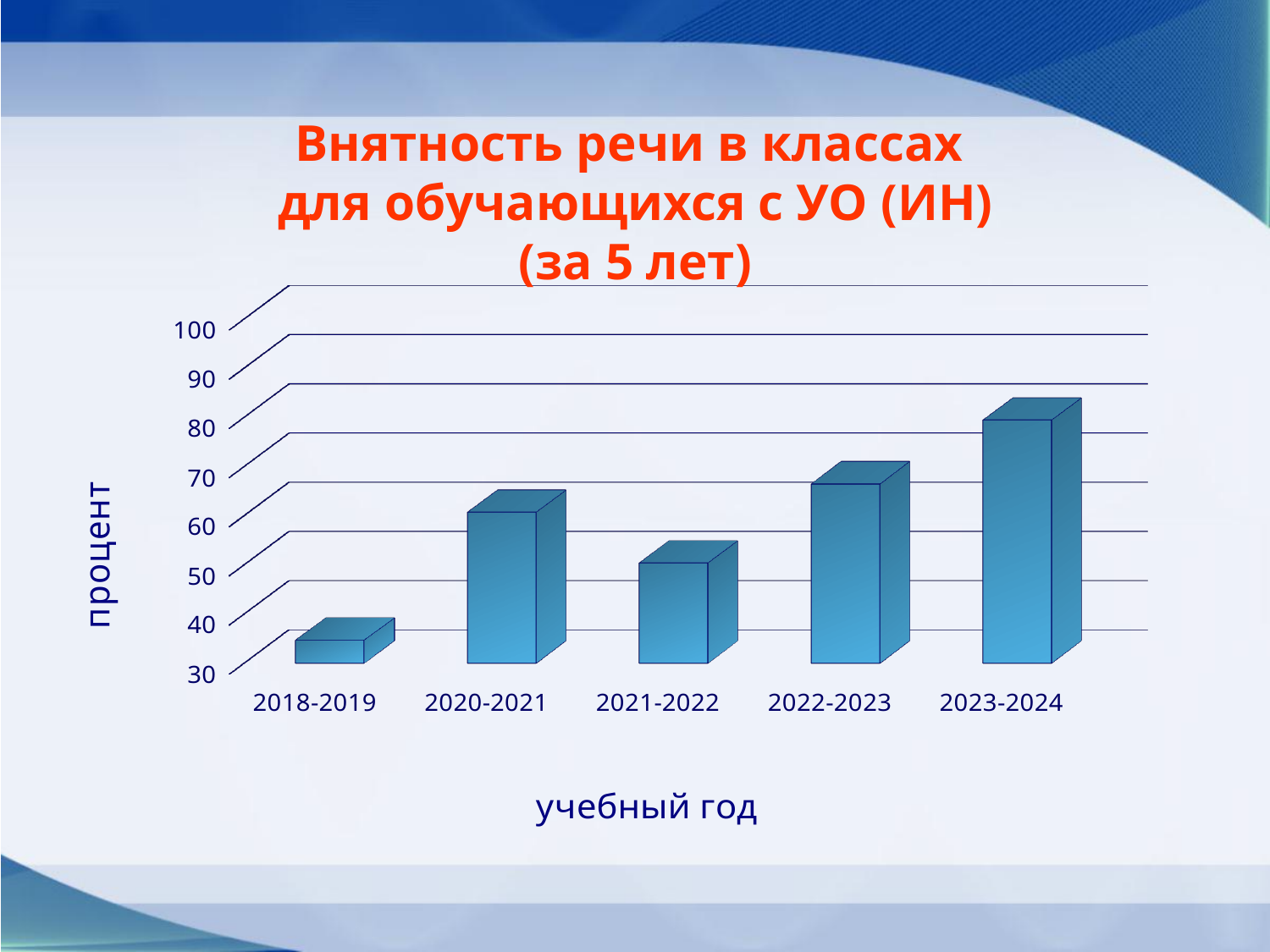
Which academic year has the highest value? 2023-2024 Is the value for 2023-2024 greater or less than 70? greater Which is larger, the value for 2020-2021 or the value for 2021-2022? 2020-2021 Is the value for 2021-2022 greater or less than 60? less How many academic years (categories) are shown on the x axis? 5 From 2021-2022 to 2023-2024, do the values rise or fall? rise Is the value for 2020-2021 greater or less than 50? greater Which academic year has the lowest value? 2018-2019 What is the label of the vertical axis? процент What kind of chart is shown on the slide? bar chart